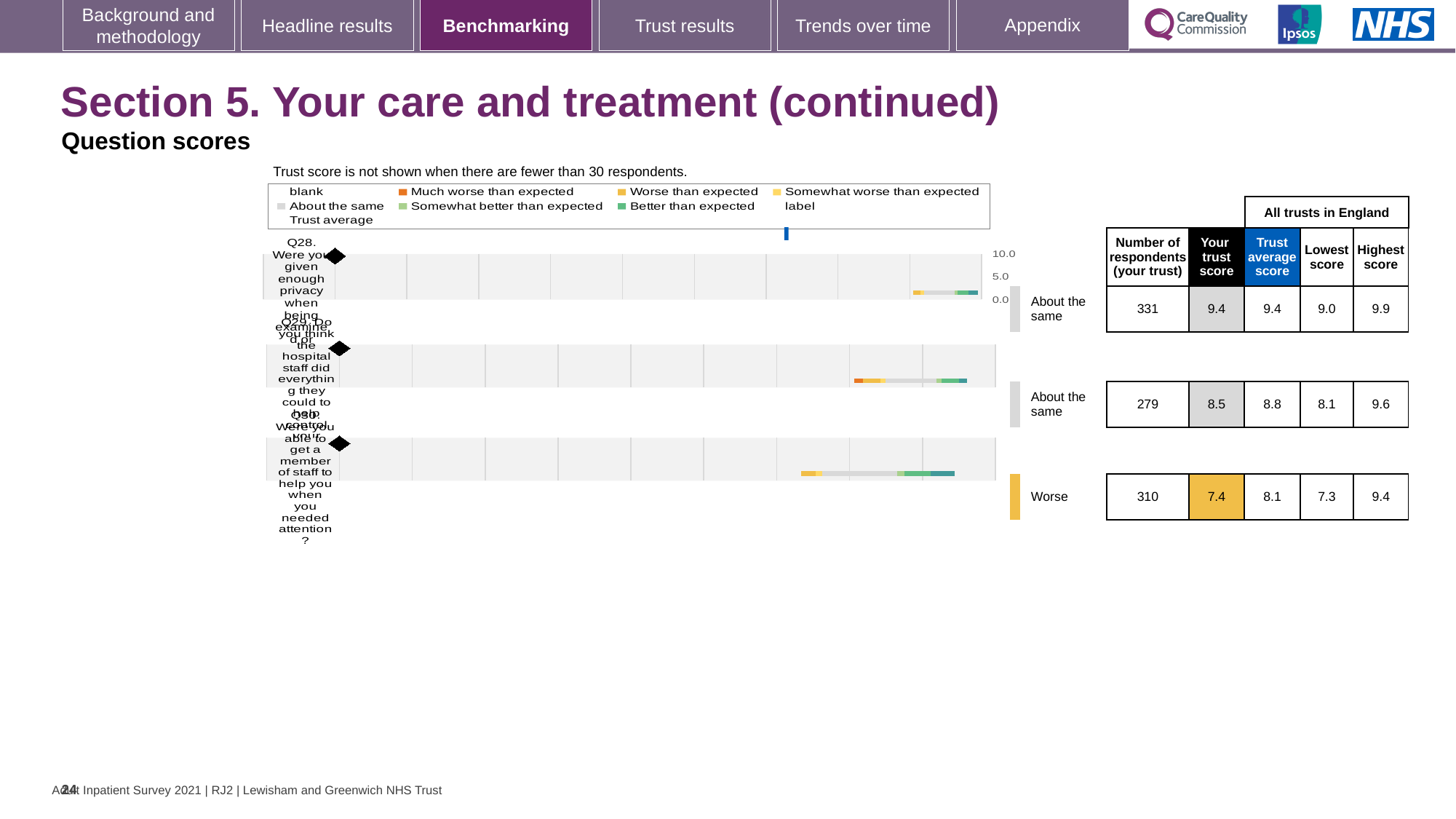
How many question charts are shown on the slide? 3 How many respondents are shown for Q30 (able to get a member of staff to help when needed)? 310 What is the 'Trust average score' for Q29 (staff did everything to help control pain)? 8.8 Which of the three questions shown has the highest 'Your trust score'? Q28 Which of the three questions shown has the lowest 'Your trust score'? Q30 What is the maximum value shown on the chart axis? 10.0 For Q29, which is larger: the 'Your trust score' or the 'Trust average score'? Trust average score What is the 'Highest score' across all trusts in England for Q28? 9.9 What is the 'Your trust score' for Q28 (privacy when being examined or treated)? 9.4 What benchmark category label is shown next to the Q30 chart? Worse What is the difference between the 'Your trust score' for Q28 and for Q30? 2.0 What is the 'Lowest score' across all trusts in England for Q30? 7.3